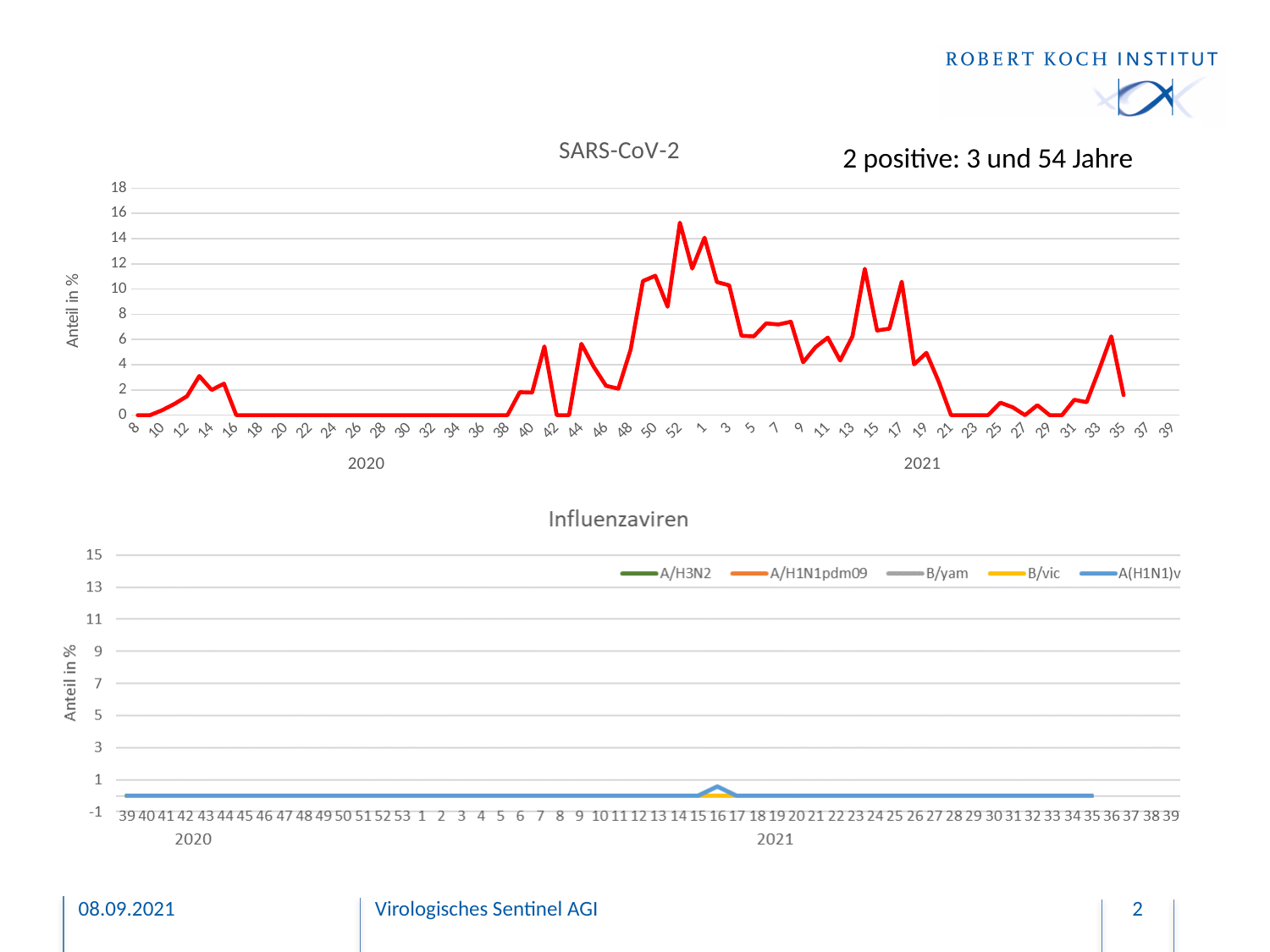
In the SARS-CoV-2 chart, which week has the highest value? 52 (2020) What kind of chart is the Influenzaviren chart? line chart In the SARS-CoV-2 chart, is the value for week 14 of 2021 greater or less than 10? greater In the SARS-CoV-2 chart, which is larger: the value for week 13 of 2020 or the value for week 44 of 2020? week 44 of 2020 In the SARS-CoV-2 chart, is the value for week 52 of 2020 greater or less than 14? greater What is the title of the top chart? SARS-CoV-2 In the SARS-CoV-2 chart, do the values rise or fall between week 38 and week 52 of 2020? rise How many series does the legend of the Influenzaviren chart list? 5 In the SARS-CoV-2 chart, is the value for week 21 of 2021 greater or less than 2? less What is the y-axis label of the Influenzaviren chart? Anteil in % What kind of chart is the SARS-CoV-2 chart? line chart In the SARS-CoV-2 chart, do the values rise or fall between week 17 and week 21 of 2021? fall